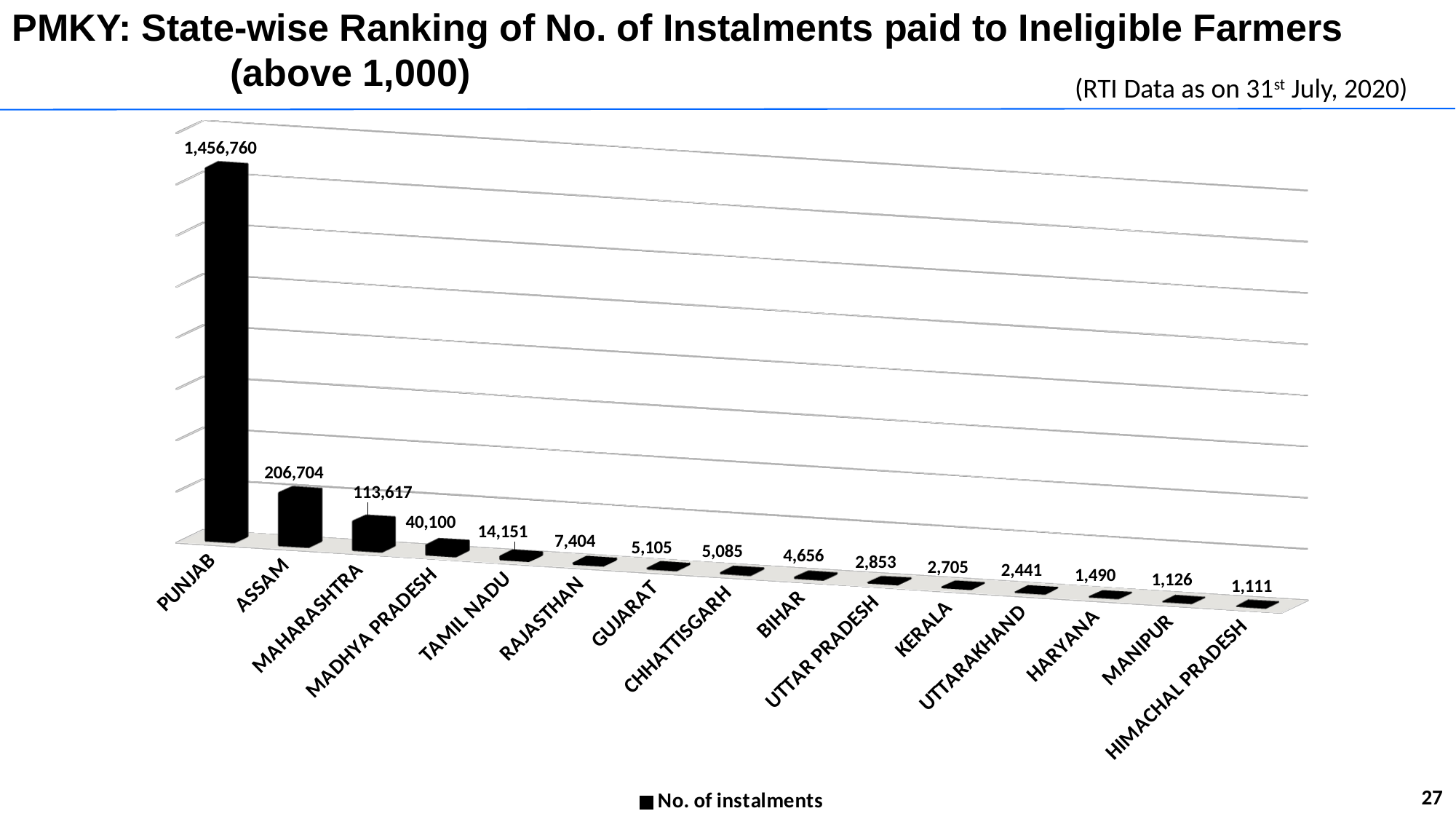
What is the number of instalments for Assam? 206,704 Which state has the highest number of instalments paid to ineligible farmers? Punjab What is the series name shown in the legend? No. of instalments What is the difference between the values for Punjab and Assam? 1,250,056 What is the value shown for Himachal Pradesh? 1,111 Which has a larger value, Tamil Nadu or Rajasthan? Tamil Nadu What kind of chart is shown on the slide? Bar chart What is the number of instalments paid to ineligible farmers in Punjab? 1,456,760 Which state has the lowest number of instalments shown on the chart? Himachal Pradesh What is the value shown for Madhya Pradesh? 40,100 What is the difference between the values for Maharashtra and Madhya Pradesh? 73,517 How many states are shown on the chart? 15